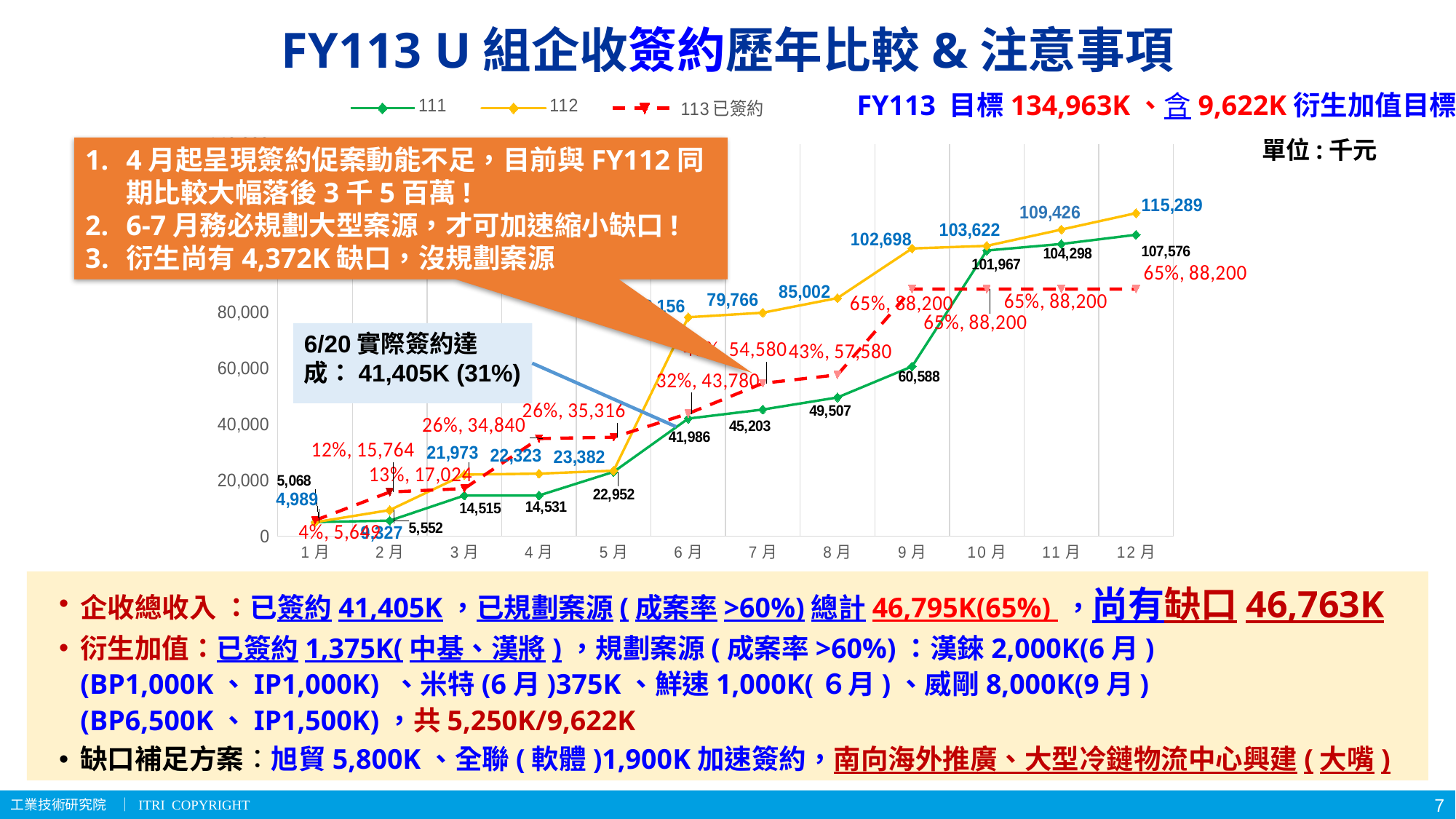
What is the difference between the 112 and 111 values in 12月? 7,713 What is the value of the 111 series in 10月? 101,967 What unit is stated for the chart values? 千元 How many months are shown along the x axis of the chart? 12 How many series does the chart legend list? 3 In 9月, which series has the larger value, 111 or 112? 112 What is the value of the 112 series in 12月? 115,289 What type of chart is shown on the slide? line chart Is the value of the 111 series in 8月 greater or less than 60,000? less What is the value of the 111 series in 12月? 107,576 What is the value of the 112 series in 9月? 102,698 In which month does the 112 series reach its highest value? 12月